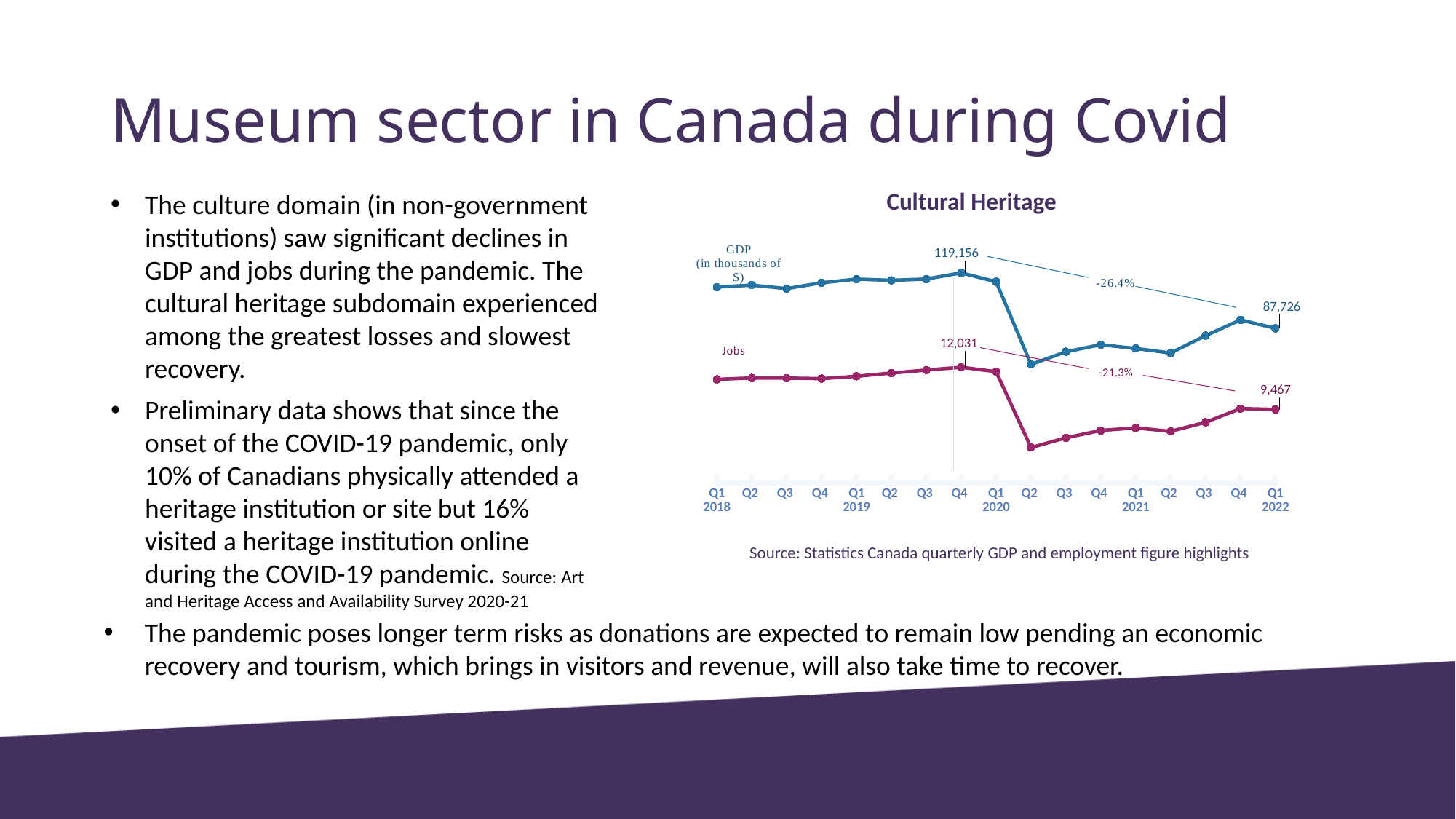
What is the Jobs value labelled at Q1 2022 in the Cultural Heritage chart? 9,467 By how much did GDP fall from its labelled Q4 2019 value to its labelled Q1 2022 value? 31,430 What is the GDP value labelled at Q1 2022 in the Cultural Heritage chart? 87,726 What percentage change is shown for Jobs between Q4 2019 and Q1 2022? -21.3% What is the title of the chart? Cultural Heritage In which quarter does the GDP line reach its lowest point? Q2 2020 How many series are plotted in the Cultural Heritage chart? 2 What percentage change is shown for GDP between Q4 2019 and Q1 2022? -26.4% What is the Jobs value labelled at Q4 2019 in the Cultural Heritage chart? 12,031 What kind of chart is shown on the slide? line chart What is the GDP value labelled at Q4 2019 in the Cultural Heritage chart? 119,156 How many quarters are shown on the x axis of the Cultural Heritage chart? 17